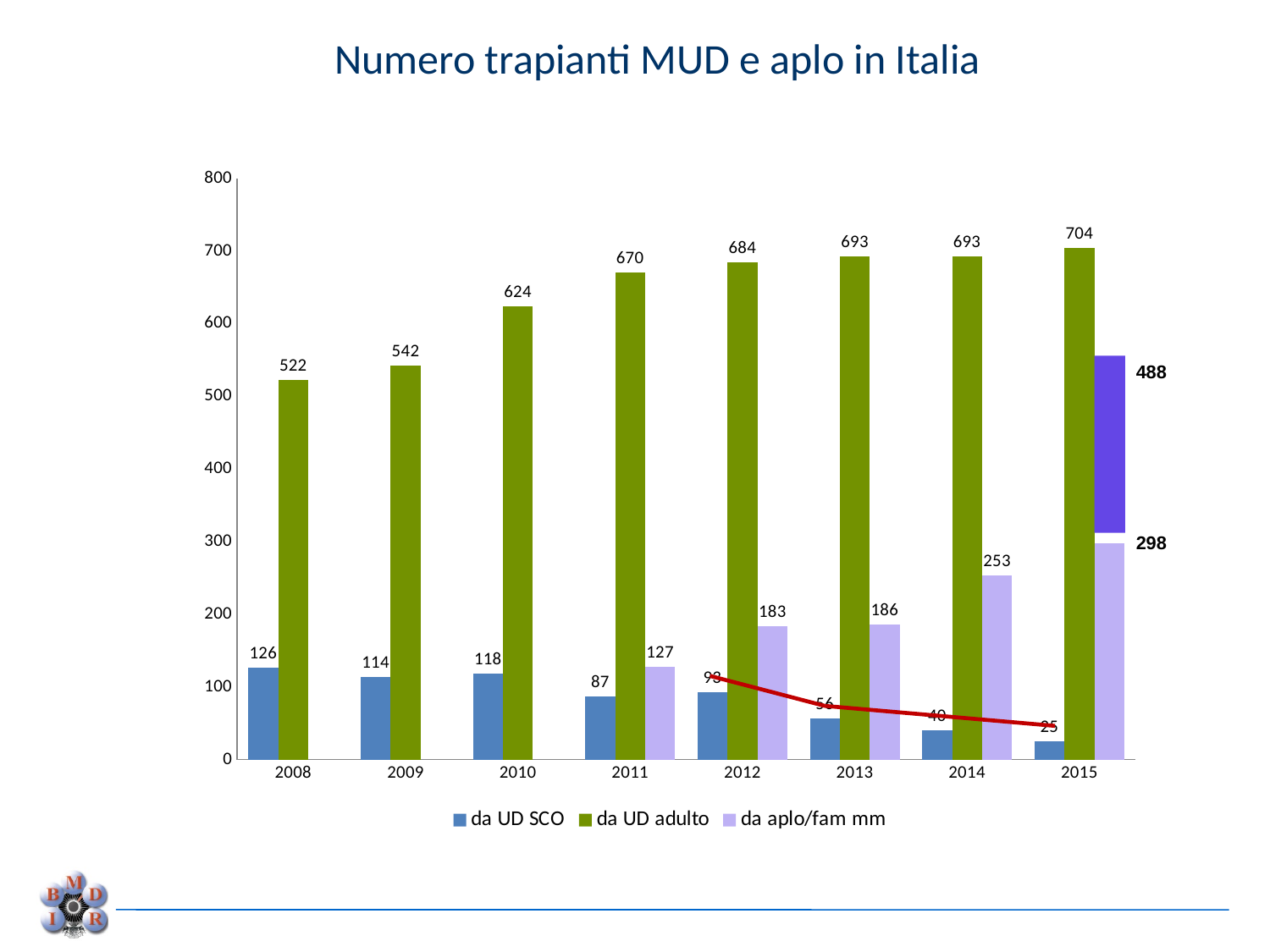
What is the value for da aplo/fam mm in 2014? 253 How many years are shown on the x axis? 8 How many series does the legend list? 3 What is the value for da UD adulto in 2010? 624 Is the value for da UD adulto in 2009 greater or less than 600? less In which year is the da UD adulto value highest? 2015 Do the da UD adulto values rise or fall from 2008 to 2015? rise What is the difference between the da UD adulto values in 2015 and 2008? 182 What kind of chart is shown on the slide? bar chart What is the value for da UD SCO in 2008? 126 In 2013, which is larger: da aplo/fam mm or da UD SCO? da aplo/fam mm In which year is the da UD SCO value lowest? 2015